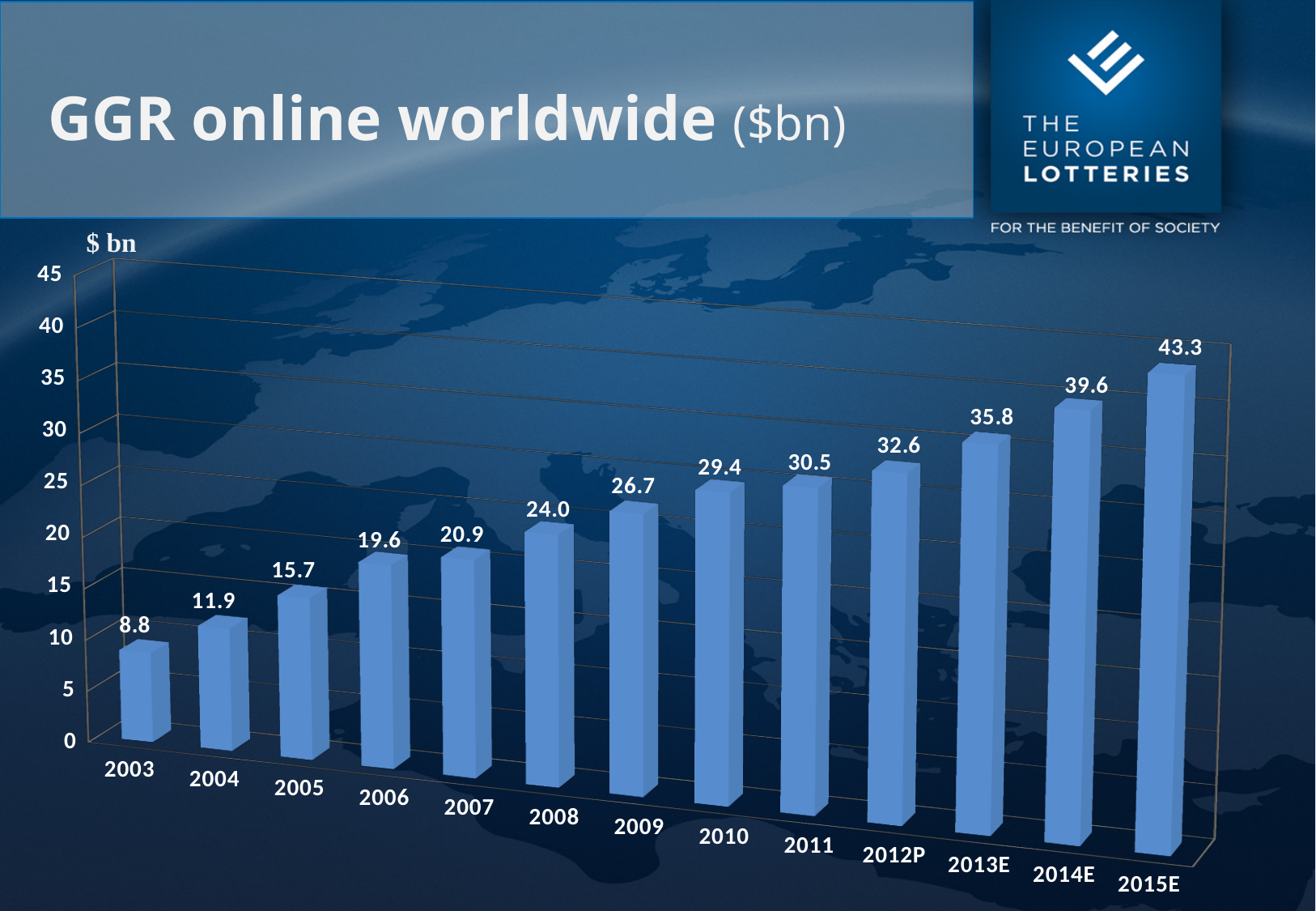
What is the GGR online worldwide value for 2008? 24.0 Which year has the lowest GGR online worldwide value? 2003 What is the difference between the values for 2015E and 2014E? 3.7 What is the value shown for 2015E? 43.3 How many years (categories) are shown on the chart? 13 Which year has the highest GGR online worldwide value? 2015E What is the difference between the values for 2010 and 2003? 20.6 Do the values rise or fall from 2003 to 2015E? rise What unit is shown on the vertical axis label of the chart? $ bn Which is larger, the value for 2011 or the value for 2009? 2011 What kind of chart is shown on the slide? bar chart What is the value shown for 2003? 8.8